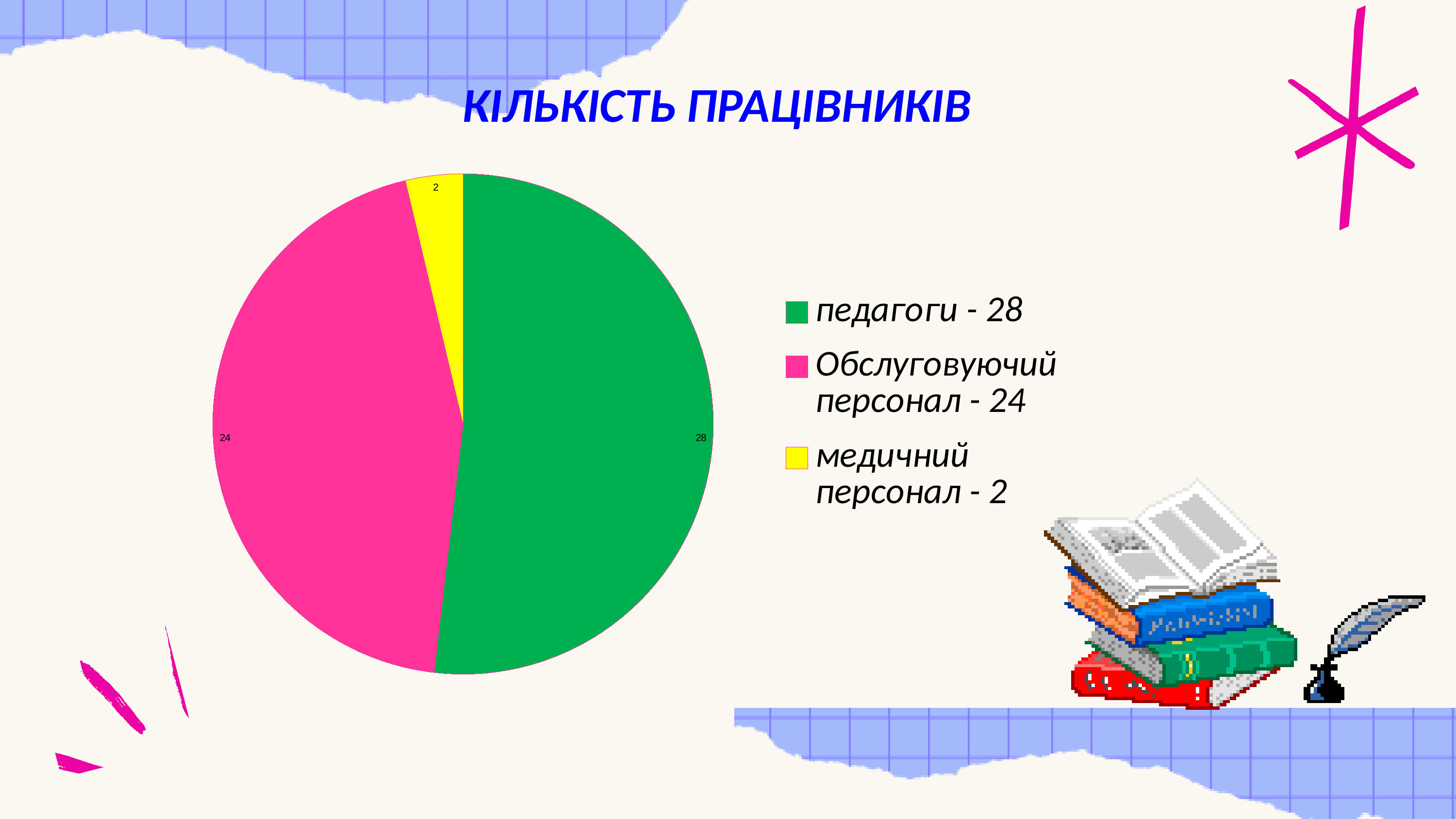
What kind of chart is shown on the slide? pie chart What colour is the slice for медичний персонал? yellow What is the total of all values in the pie chart? 54 What is the value for педагоги in the pie chart? 28 Which category has the smallest slice in the pie chart? медичний персонал What is the value for Обслуговуючий персонал in the pie chart? 24 Which category has the largest slice in the pie chart? педагоги What is the difference between the values for педагоги and Обслуговуючий персонал? 4 Which is larger, the value for педагоги or the value for медичний персонал? педагоги What is the value for медичний персонал in the pie chart? 2 How many categories are shown in the pie chart? 3 What is the difference between the values for Обслуговуючий персонал and медичний персонал? 22